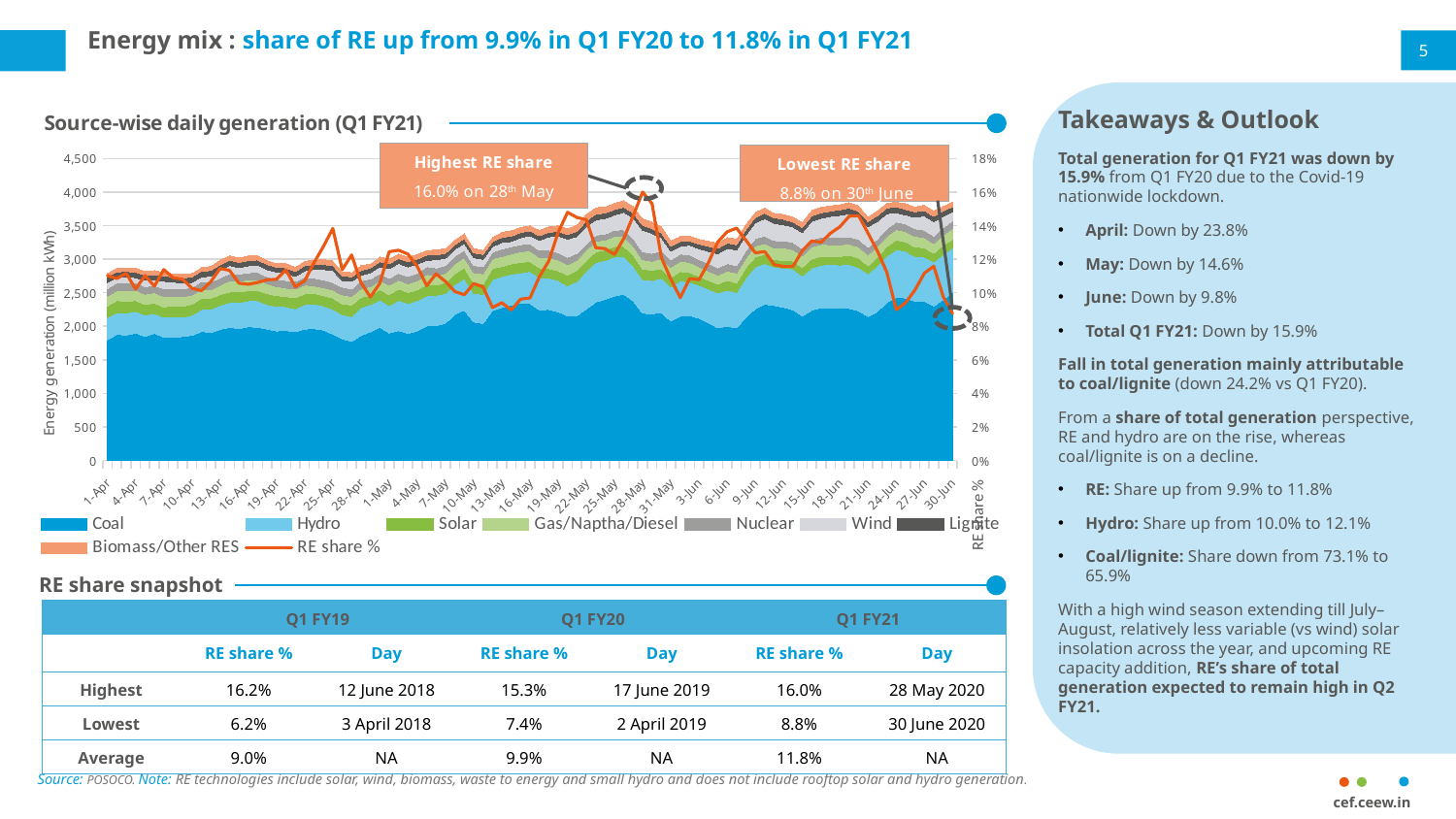
On which date does the chart mark the highest RE share? 28th May What kind of chart is used for the source-wise daily generation? Stacked area chart with a line for RE share % Is the total daily generation on 1-Apr greater or less than 3,500 million kWh? less Which source accounts for the largest share of daily generation in the chart? Coal Does total daily generation generally rise or fall from early April to late May? Rise Is the RE share on 28th May higher or lower than on 30th June? Higher What is the lowest RE share marked on the source-wise daily generation chart? 8.8% What is the title of the chart on the slide? Source-wise daily generation (Q1 FY21) How many series does the legend of the source-wise daily generation chart list? 9 What is the difference between the highest and lowest RE share marked on the chart? 7.2 percentage points What is the highest RE share marked on the source-wise daily generation chart? 16.0% On which date does the chart mark the lowest RE share? 30th June